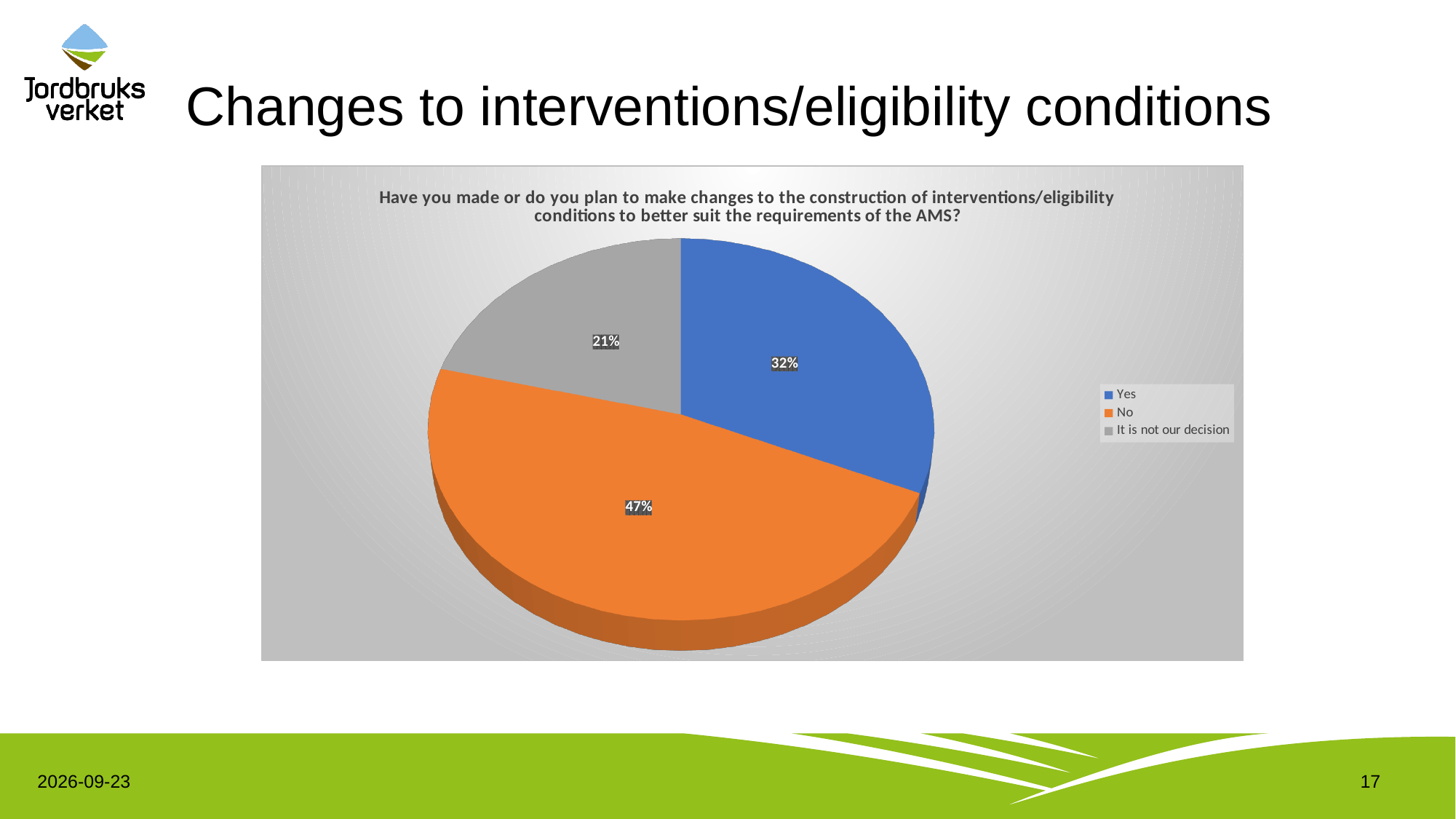
What percentage of respondents answered "Yes"? 32% How many entries does the legend list? 3 Which response has the smallest share of the pie? It is not our decision Which is larger, the "Yes" slice or the "It is not our decision" slice? Yes How many slices does the pie chart have? 3 What colour is the "No" slice? orange What is the difference in percentage points between the "No" and "Yes" slices? 15 What is the combined share of the "Yes" and "No" slices? 79% What type of chart is shown on the slide? pie chart What percentage of respondents answered "It is not our decision"? 21% Which response has the largest share of the pie? No What percentage of respondents answered "No"? 47%